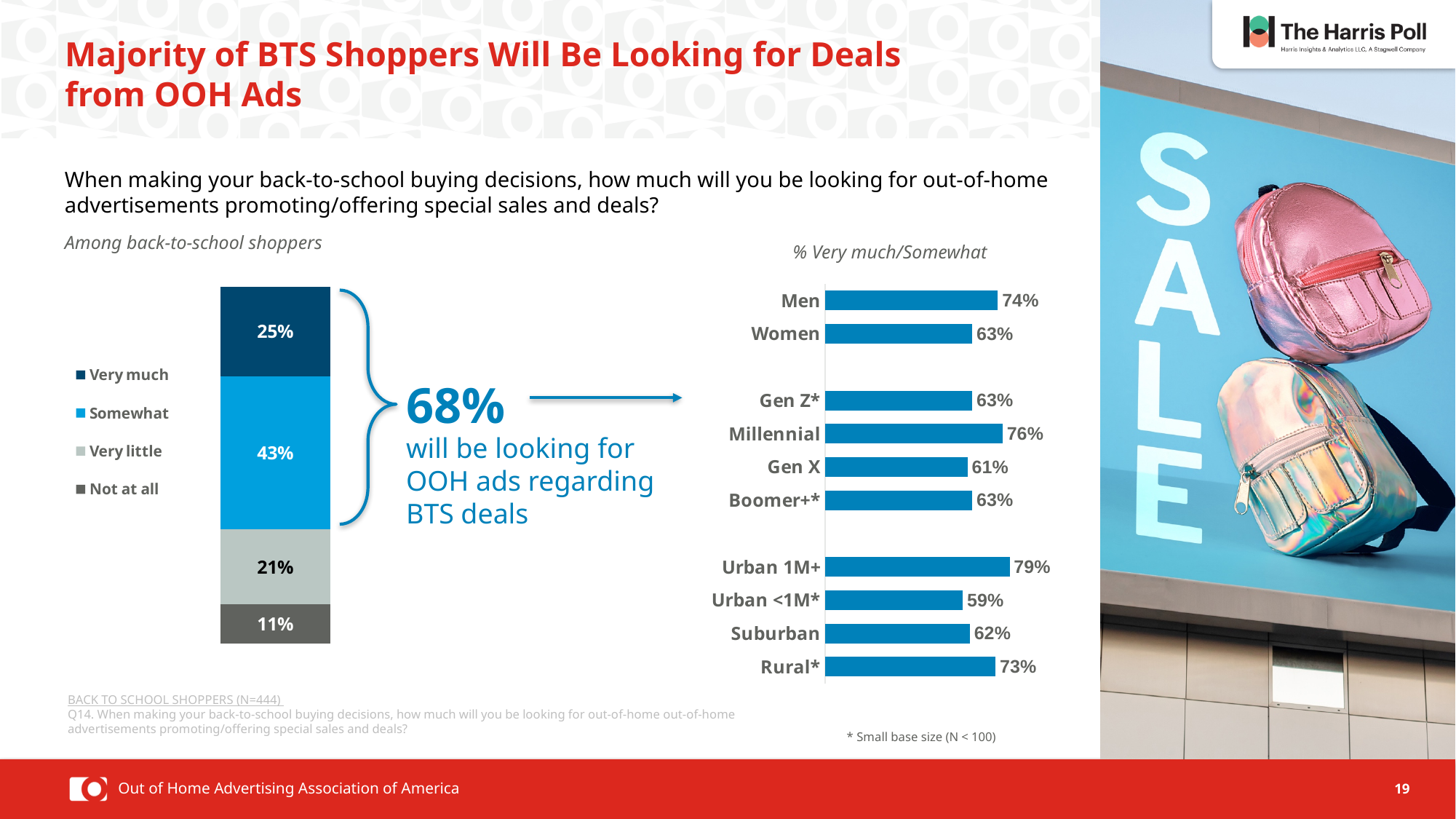
In the stacked bar chart on the left, which response has the largest share? Somewhat In the "% Very much/Somewhat" bar chart on the right, what is the difference between Men and Women? 11 percentage points In the stacked bar chart on the left, what is the combined share of "Very much" and "Somewhat"? 68% In the "% Very much/Somewhat" bar chart on the right, what is the value for Millennial? 76% In the stacked bar chart on the left, what percentage answered "Not at all"? 11% In the stacked bar chart on the left, how many series does the legend list? 4 In the "% Very much/Somewhat" bar chart on the right, what is the value for Suburban? 62% In the "% Very much/Somewhat" bar chart on the right, which group has the lowest value? Urban <1M* In the "% Very much/Somewhat" bar chart on the right, how many groups are plotted? 10 In the "% Very much/Somewhat" bar chart on the right, which group has the highest value? Urban 1M+ In the stacked bar chart on the left, what percentage of back-to-school shoppers answered "Somewhat"? 43% In the "% Very much/Somewhat" bar chart on the right, which is larger, Rural* or Gen X? Rural*